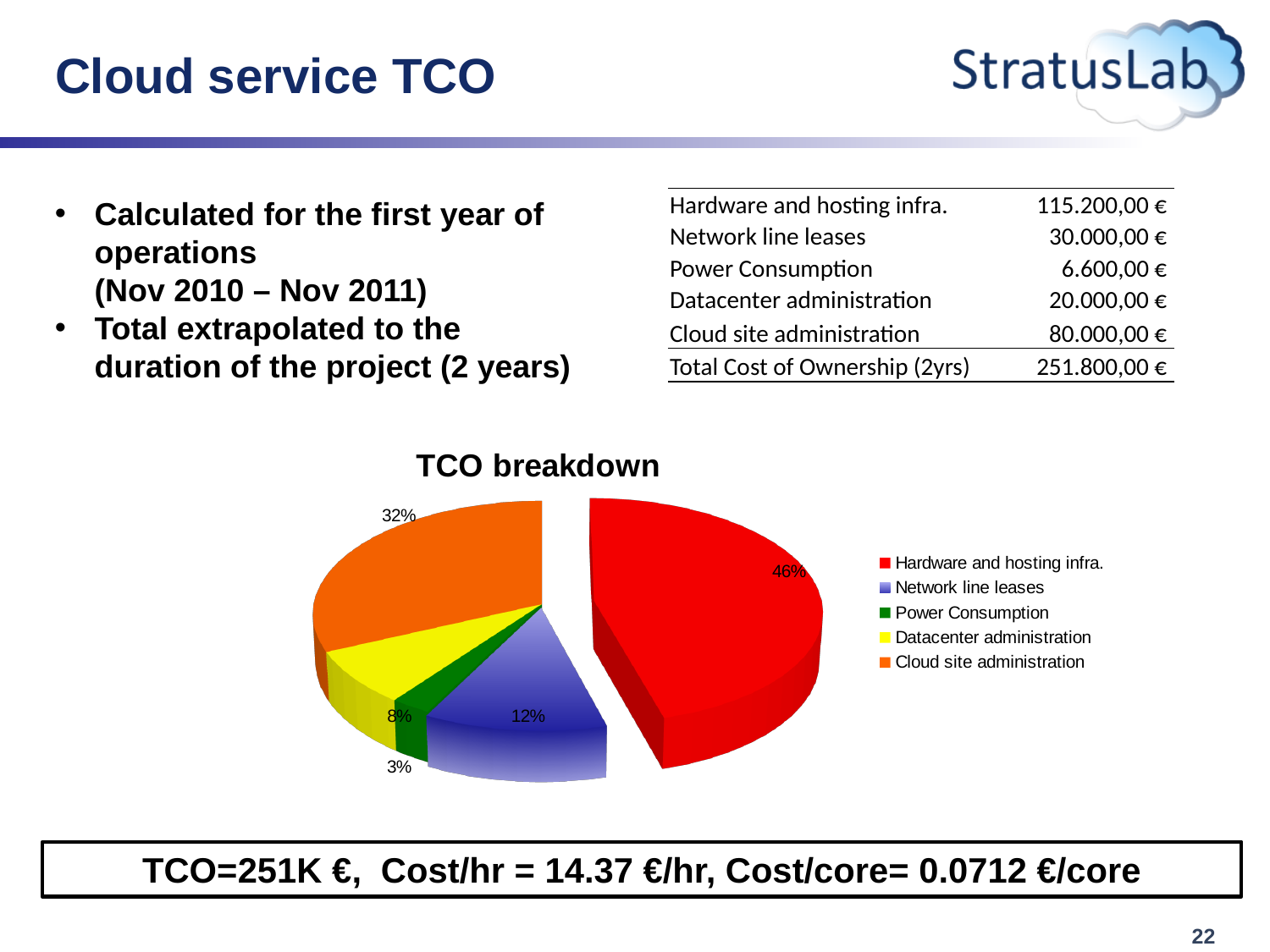
What kind of chart is the "TCO breakdown" chart? pie chart What share of the "TCO breakdown" pie is Cloud site administration? 32% Which category has the smallest slice in the "TCO breakdown" pie chart? Power Consumption In the "TCO breakdown" chart, which slice is larger: Datacenter administration or Network line leases? Network line leases What share of the "TCO breakdown" pie is Network line leases? 12% Which category has the largest slice in the "TCO breakdown" pie chart? Hardware and hosting infra. How many slices does the "TCO breakdown" pie chart have? 5 How many entries does the legend of the "TCO breakdown" chart list? 5 In the "TCO breakdown" chart, what is the difference in percentage points between Hardware and hosting infra. and Cloud site administration? 14 percentage points What share of the "TCO breakdown" pie is Hardware and hosting infra.? 46% What is the title of the chart on the slide? TCO breakdown